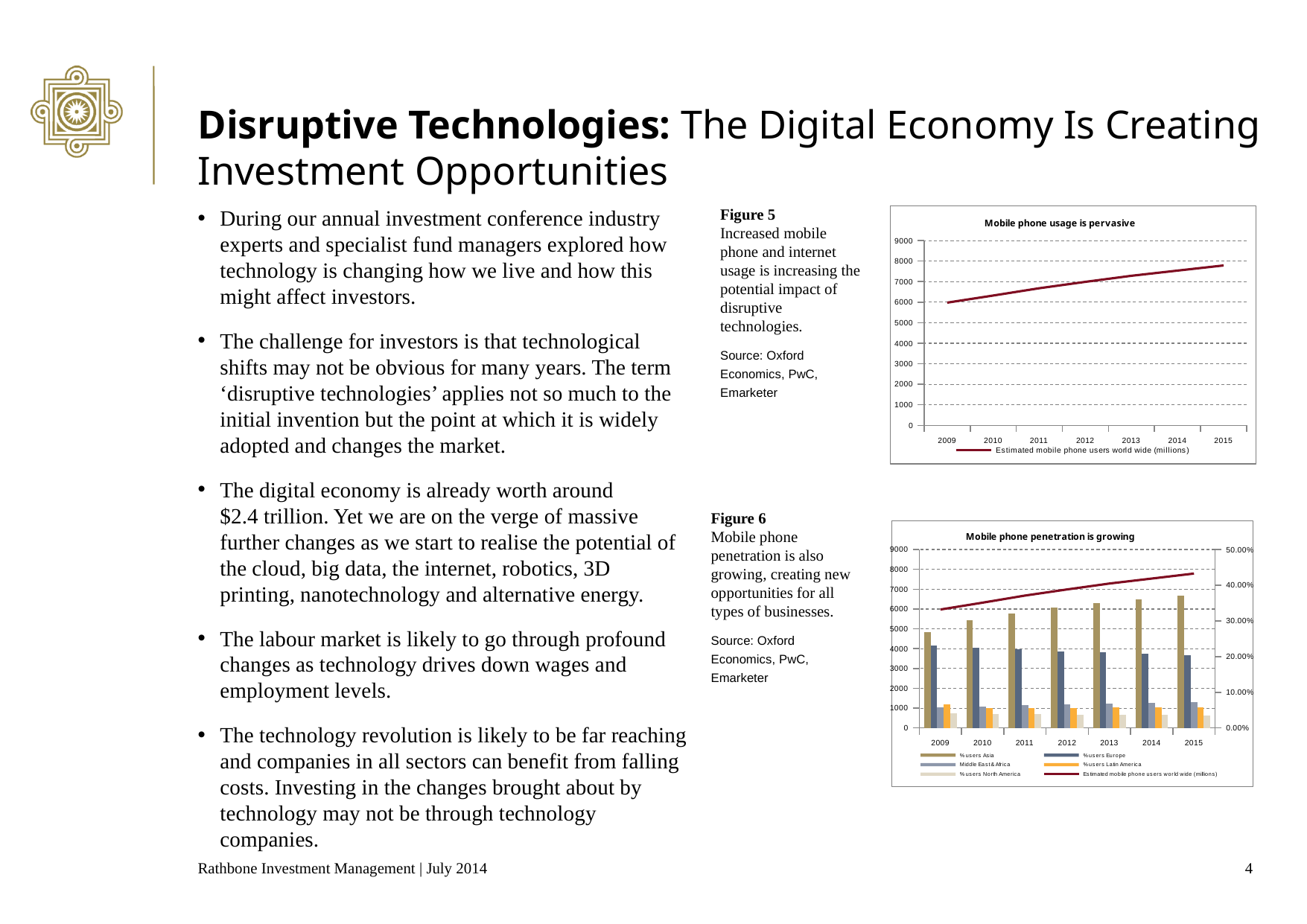
In the 'Mobile phone penetration is growing' chart, which bar series has the tallest bars? % users Asia In the 'Mobile phone usage is pervasive' chart, is the value for 2015 greater or less than 7000? greater What is the title of the upper chart on the slide? Mobile phone usage is pervasive In the 'Mobile phone penetration is growing' chart, which is larger in 2015: the '% users Asia' bar or the '% users Europe' bar? % users Asia How many series does the legend of the 'Mobile phone usage is pervasive' chart list? 1 What kind of chart is 'Mobile phone usage is pervasive'? line chart In the 'Mobile phone usage is pervasive' chart, do the values rise or fall from 2009 to 2015? rise How many years are plotted on the x axis of the 'Mobile phone usage is pervasive' chart? 7 How many series does the legend of the 'Mobile phone penetration is growing' chart list? 6 In the 'Mobile phone usage is pervasive' chart, is the value for 2009 greater or less than 7000? less In the 'Mobile phone penetration is growing' chart, do the '% users Asia' bars rise or fall from 2009 to 2015? rise How many years are shown on the x axis of the 'Mobile phone penetration is growing' chart? 7